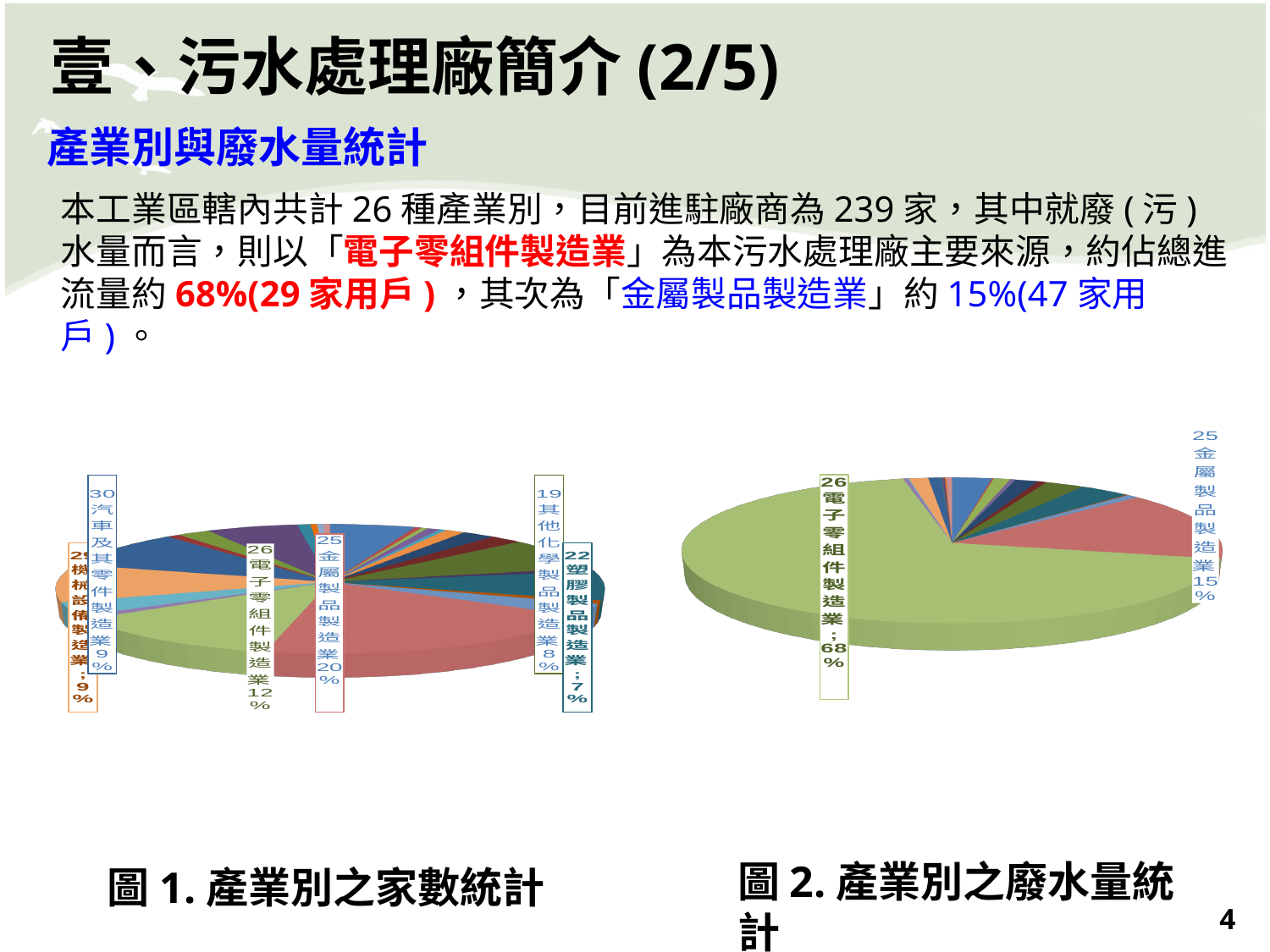
In Figure 2 (產業別之廢水量統計), which industry has the largest slice? 電子零組件製造業 In Figure 1 (產業別之家數統計), what share does 塑膠製品製造業 have? 7% In Figure 2 (產業別之廢水量統計), what is the difference in percentage points between 電子零組件製造業 and 金屬製品製造業? 53 percentage points In Figure 1 (產業別之家數統計), what is the difference in percentage points between 金屬製品製造業 and 電子零組件製造業? 8 percentage points What kind of chart is Figure 1 (圖1. 產業別之家數統計)? pie chart In Figure 1 (產業別之家數統計), what share does 其他化學製品製造業 have? 8% In Figure 1 (產業別之家數統計), which is larger, the share of 金屬製品製造業 or the share of 電子零組件製造業? 金屬製品製造業 In Figure 2 (產業別之廢水量統計), what share does 電子零組件製造業 have? 68% In Figure 1 (產業別之家數統計), what share does 電子零組件製造業 have? 12% What kind of chart is Figure 2 (圖2. 產業別之廢水量統計)? pie chart In Figure 2 (產業別之廢水量統計), what share does 金屬製品製造業 have? 15% In Figure 1 (產業別之家數統計), what share does 金屬製品製造業 have? 20%